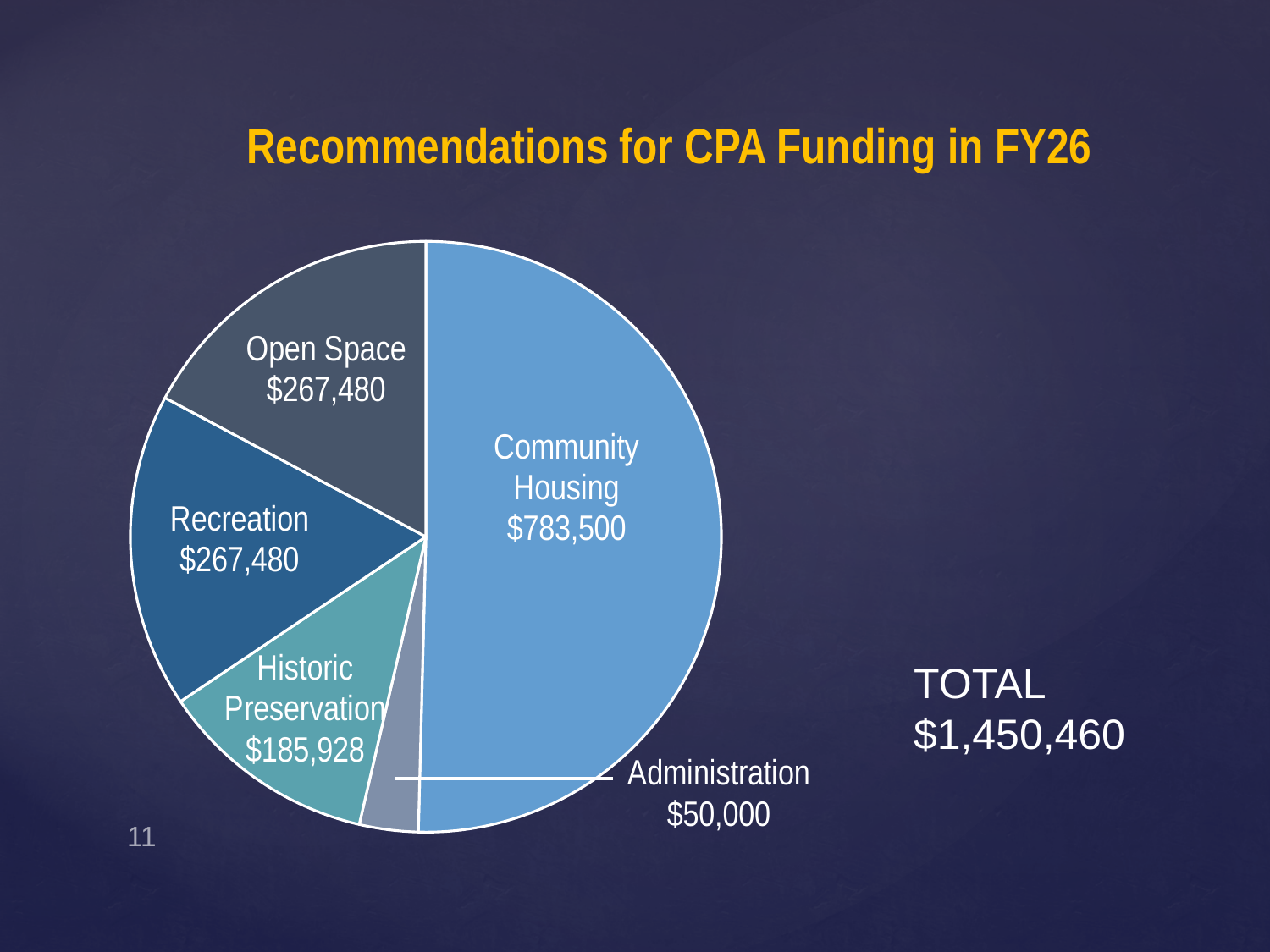
What kind of chart is shown on the slide? Pie chart What is the value for Open Space? $267,480 Which category receives the largest amount of funding? Community Housing How many categories are shown in the pie chart? 5 What is the title of the chart? Recommendations for CPA Funding in FY26 Which is larger, Recreation or Historic Preservation? Recreation Which category receives the smallest amount of funding? Administration What is the difference between the Historic Preservation and Administration values? $135,928 What is the value for Administration? $50,000 What is the value for Community Housing? $783,500 What is the difference between the Community Housing and Open Space values? $516,020 What is the value for Historic Preservation? $185,928